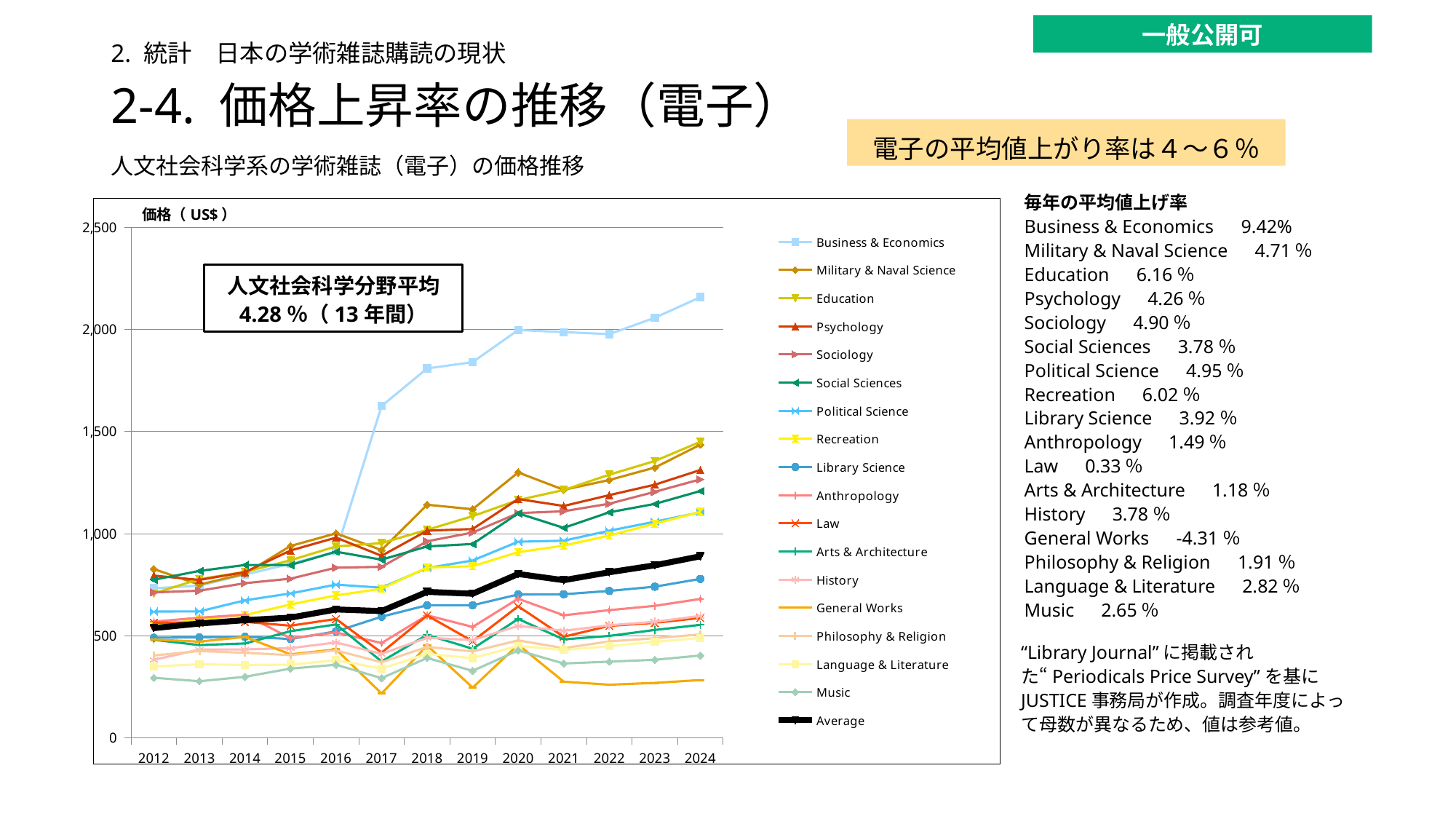
Which series has the lowest value in 2024? General Works Is the value for General Works in 2024 greater or less than 500? less How many series does the chart's legend list? 18 What is the first year shown on the x axis of the chart? 2012 Is the value for Average in 2024 greater or less than 1,000? less In 2024, which is larger: the value for Business & Economics or the value for Music? Business & Economics Is the value for Business & Economics in 2012 greater or less than 1,000? less How many years are shown along the x axis of the chart? 13 What kind of chart is shown on the slide? line chart Which series has the highest value in 2024? Business & Economics Does the Business & Economics line rise or fall from 2012 to 2024? rise